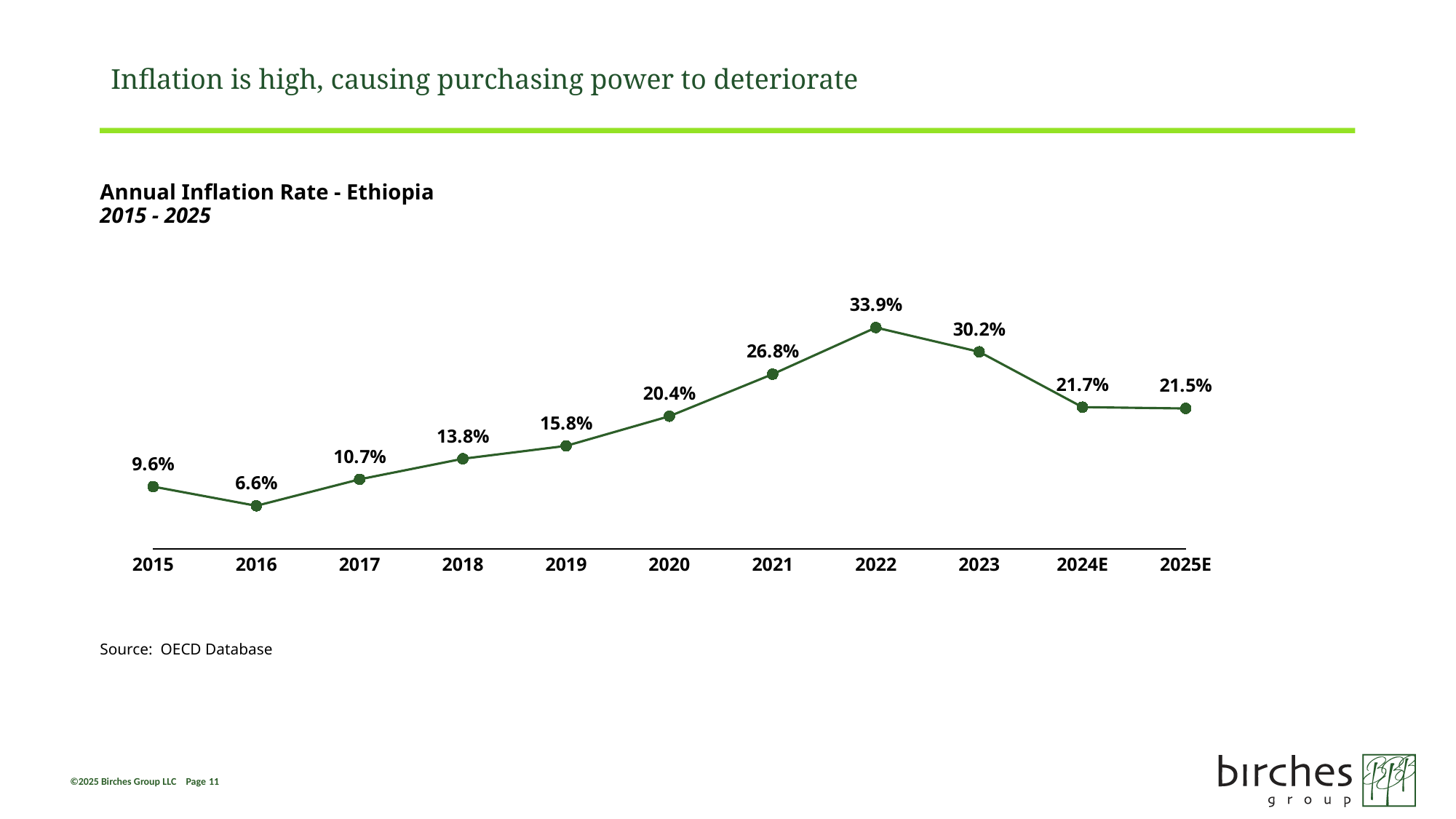
What is the difference between the inflation rate in 2021 and in 2020? 6.4% Does the inflation rate rise or fall from 2016 to 2022? Rise What is the annual inflation rate shown for 2025E? 21.5% What is the difference between the inflation rate in 2022 and in 2023? 3.7% What is the annual inflation rate for Ethiopia in 2022? 33.9% Which year has a higher inflation rate, 2019 or 2018? 2019 How many years (data points) are plotted on the chart? 11 What is the source cited for the chart data? OECD Database Which year has the highest annual inflation rate on the chart? 2022 What kind of chart is shown on the slide? Line chart What is the annual inflation rate for Ethiopia in 2016? 6.6% Which year has the lowest annual inflation rate on the chart? 2016